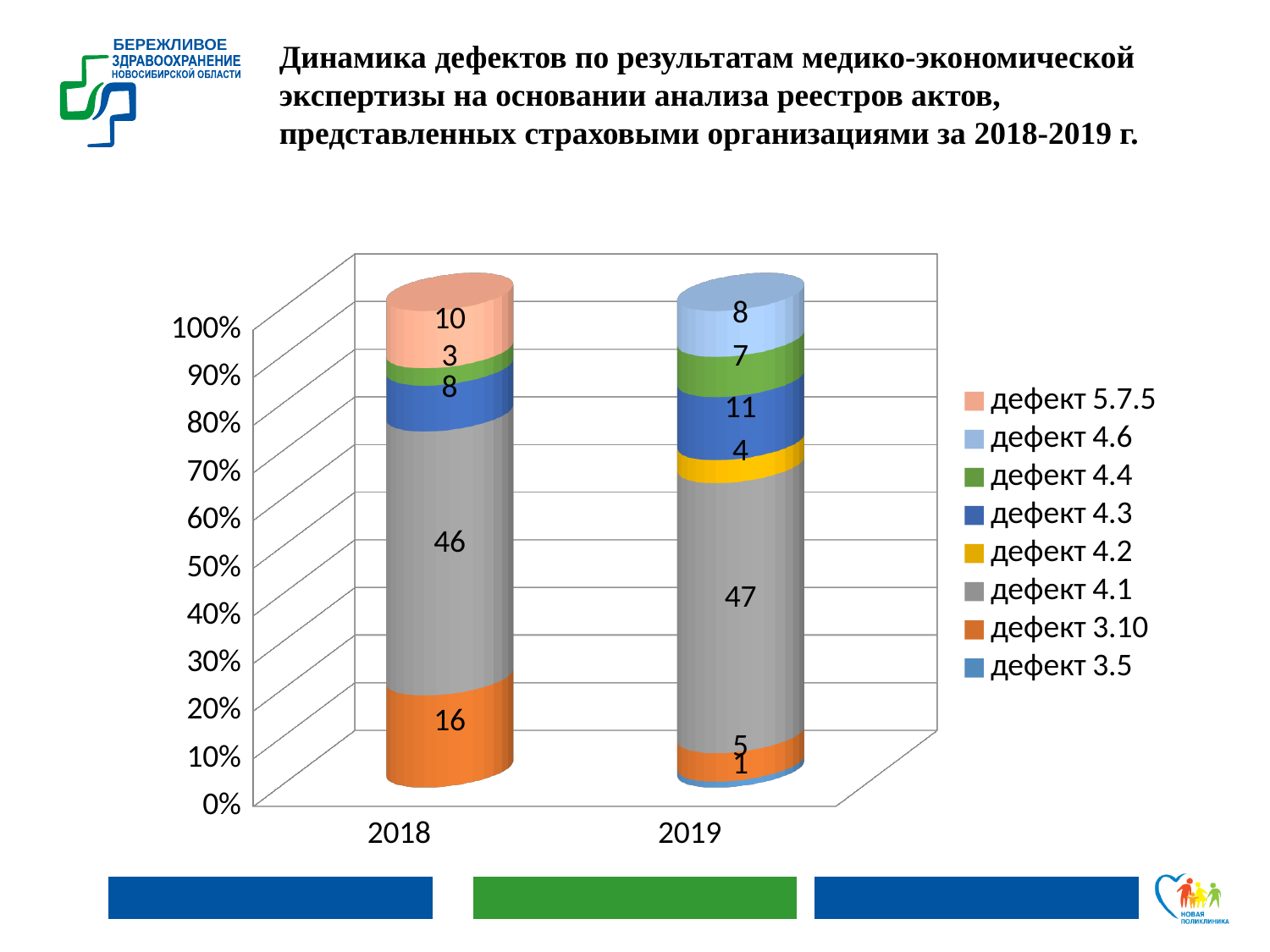
What is the total of the 2018 stacked bar? 83 Which series has the largest value in the 2019 bar? дефект 4.1 What is the value for дефект 4.3 in 2019? 11 What is the value for дефект 4.1 in 2019? 47 What is the value for дефект 4.2 in 2019? 4 Which is larger: дефект 4.4 in 2018 or дефект 4.4 in 2019? 2019 Which series has the smallest value in the 2019 bar? дефект 3.5 What is the difference between the дефект 3.10 values for 2018 and 2019? 11 What is the value for дефект 4.1 in 2018? 46 What kind of chart is shown on the slide? Stacked bar chart How many series does the legend list? 8 What is the value for дефект 3.10 in 2018? 16